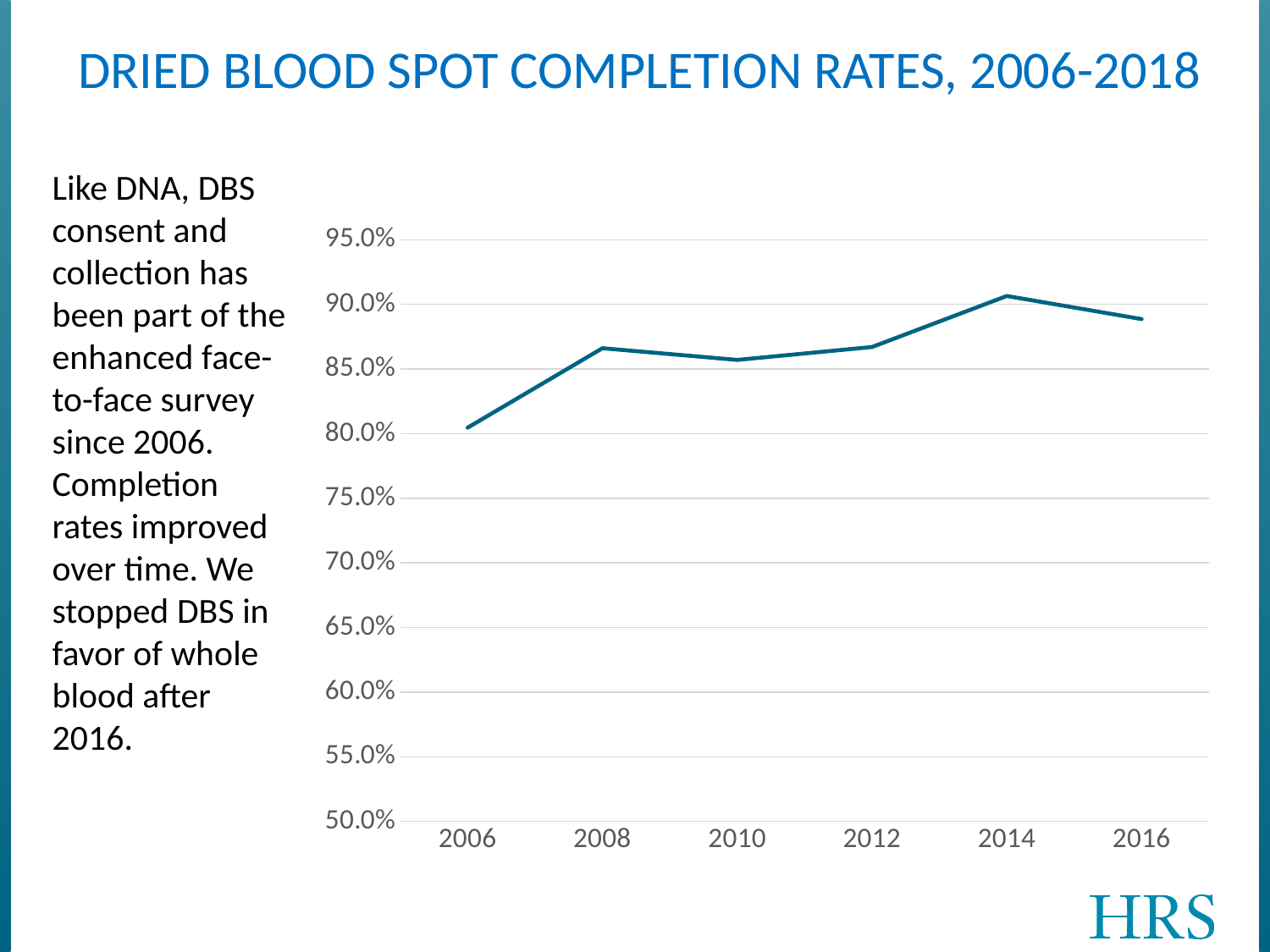
In which year is the completion rate highest? 2014 Is the completion rate for 2008 greater or less than 85.0%? greater Is the completion rate for 2006 greater or less than 85.0%? less How many years are plotted on the x axis of the chart? 6 Which year has the higher completion rate, 2014 or 2016? 2014 In which year is the completion rate lowest? 2006 Is the completion rate for 2014 greater or less than 85.0%? greater Which year has the higher completion rate, 2006 or 2008? 2008 Does the completion rate rise or fall from 2014 to 2016? fall What is the title of the chart? DRIED BLOOD SPOT COMPLETION RATES, 2006-2018 What kind of chart is shown on the slide? line chart